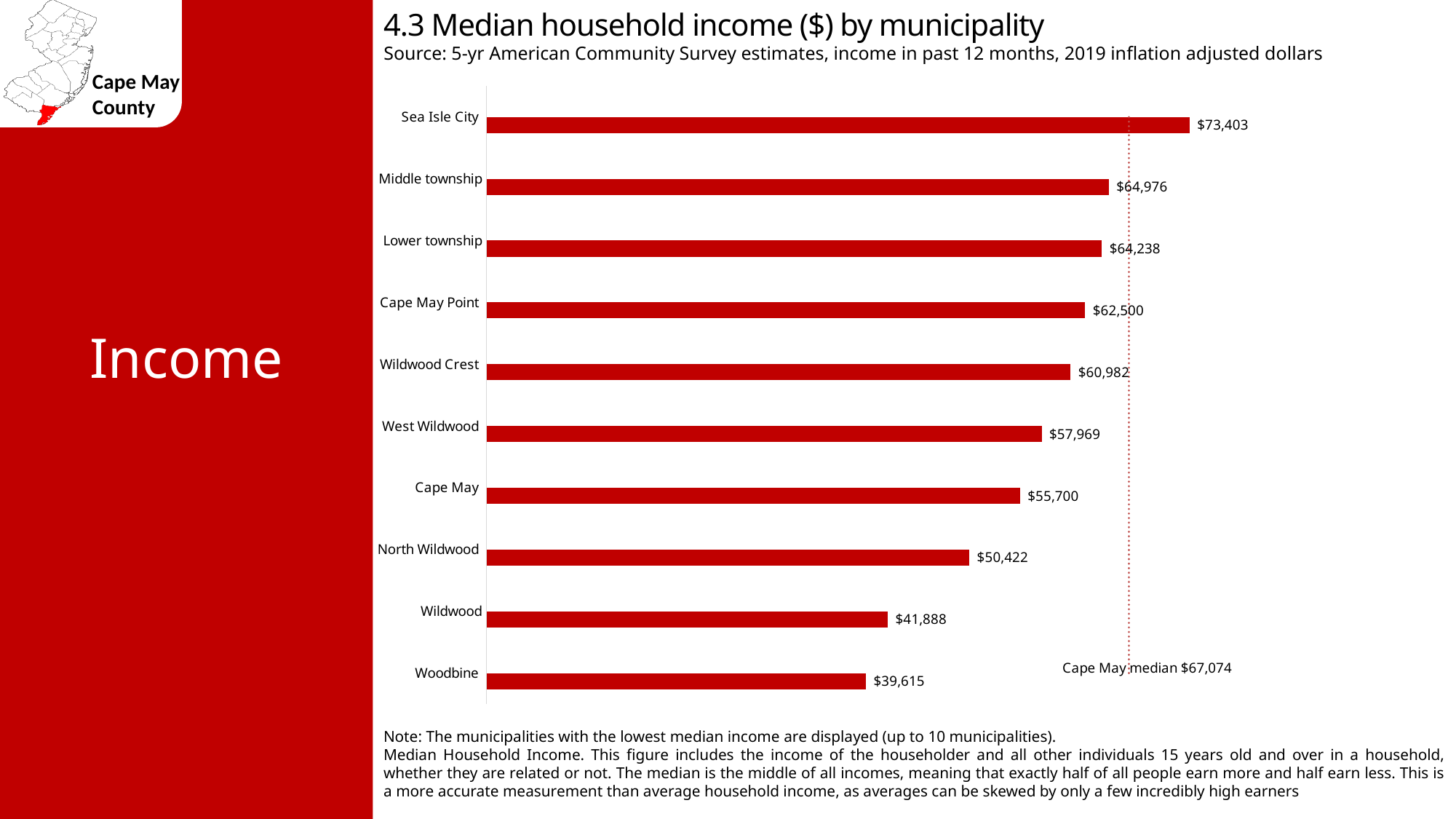
What is the difference in median household income between Middle township and Lower township? $738 What is the title of the chart? 4.3 Median household income ($) by municipality Which has a higher median household income, Cape May or West Wildwood? West Wildwood What is the median household income for Sea Isle City? $73,403 What is the median household income for North Wildwood? $50,422 What is the difference in median household income between Sea Isle City and Woodbine? $33,788 Which municipality has the highest median household income on the chart? Sea Isle City What kind of chart is shown on the slide? Bar chart How many municipalities are shown on the chart? 10 Which municipality has the lowest median household income on the chart? Woodbine What is the median household income for Woodbine? $39,615 What is the Cape May median household income marked by the dotted line? $67,074